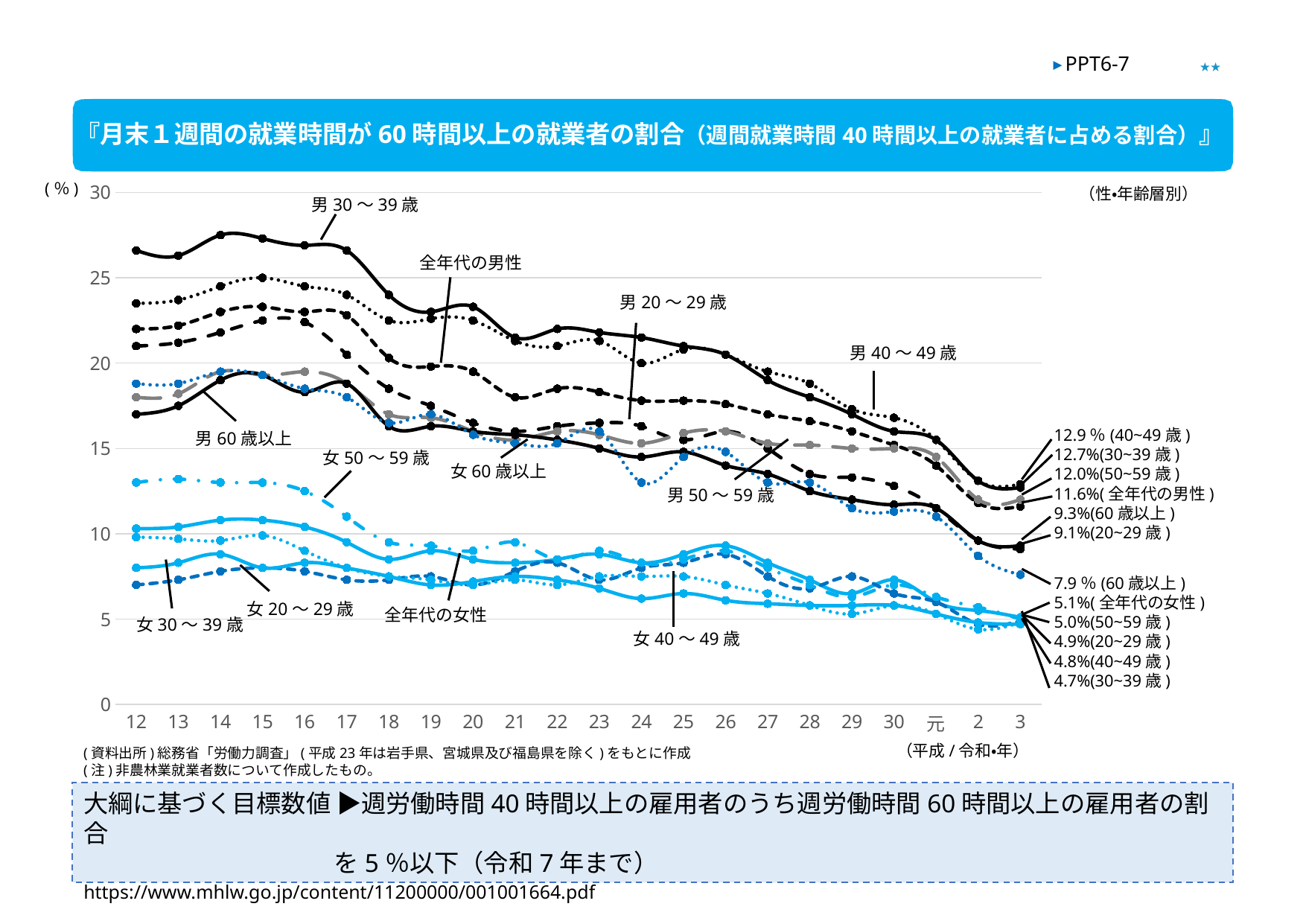
How many year points are shown on the x axis? 22 Does the 男30〜39歳 line generally rise or fall from 平成12年 to 令和3年? fall What is the difference between the end-of-chart values for 全年代の男性 (11.6%) and 全年代の女性 (5.1%)? 6.5 percentage points What kind of chart is shown on the slide? line chart What is the value labeled for 全年代の女性 at the right end of the chart? 5.1% Which series has the lowest labeled value at the right end of the chart? 女30〜39歳 (4.7%) Which series has the highest labeled value at the right end of the chart? 男40〜49歳 (12.9%) What is the value labeled for 全年代の男性 at the right end of the chart? 11.6% What is the value labeled for the 40~49歳 male line at the right end of the chart (令和3年)? 12.9% Is the value for 女30〜39歳 in 平成12年 greater or less than 10? less What is the value labeled for the 30~39歳 female line at the right end of the chart? 4.7% Is the value for 男30〜39歳 in 平成14年 greater or less than 25? greater